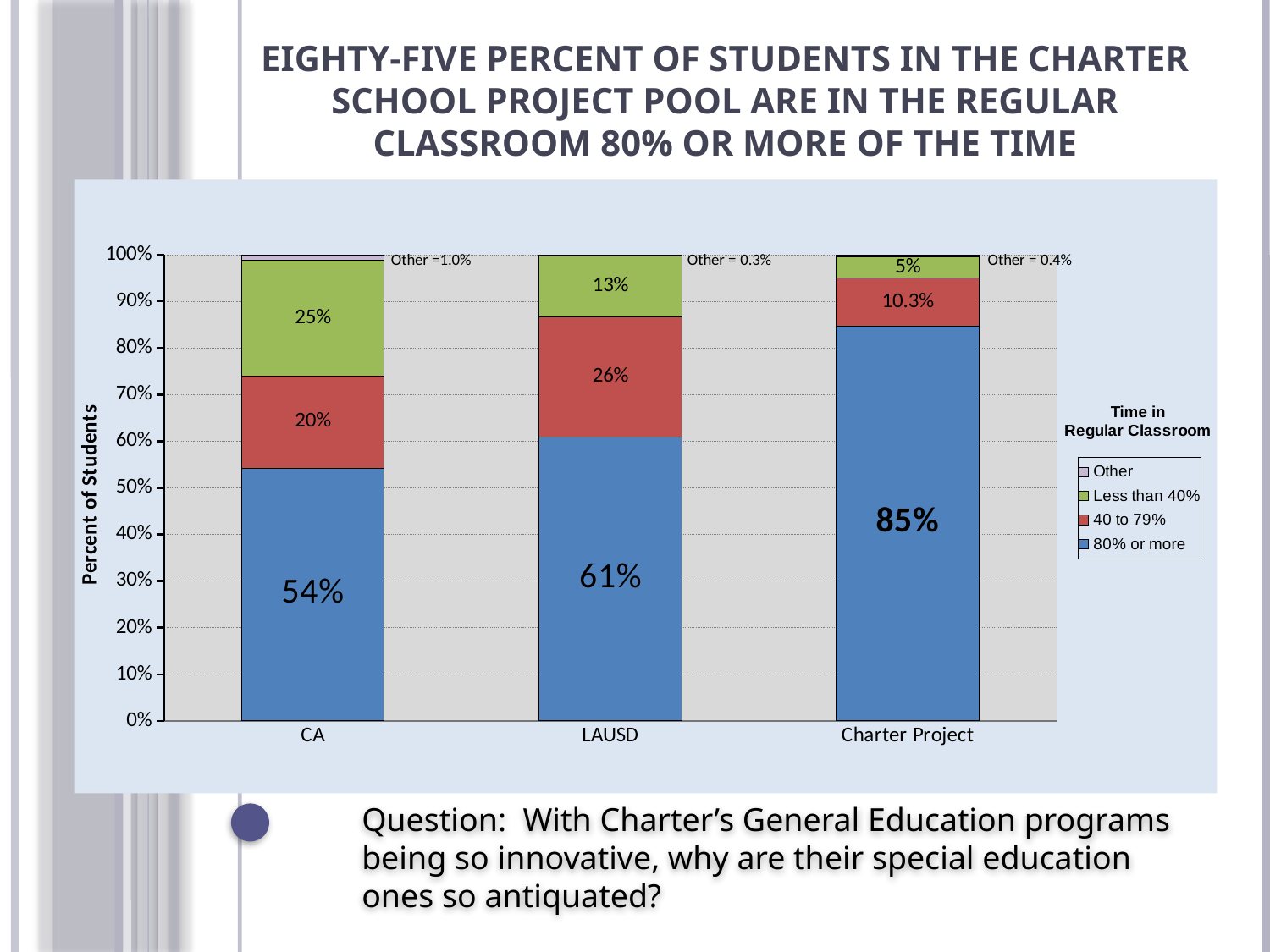
What is the value for the 40 to 79% segment for LAUSD? 26% How many series does the legend list? 4 How many categories are shown on the x axis? 3 What kind of chart is shown on the slide? Stacked bar chart What is the value for the 40 to 79% segment for the Charter Project? 10.3% What is the value for the Less than 40% segment for the Charter Project? 5% What is the 'Other' value shown for CA? 1.0% What percentage of CA students are in the regular classroom 80% or more of the time? 54% Which category has the highest share of students in the regular classroom 80% or more of the time? Charter Project What is the difference between the 80% or more values for the Charter Project and CA? 31% Which category has the lowest value for the Less than 40% segment? Charter Project Which is larger: the Less than 40% segment for CA or for LAUSD? CA